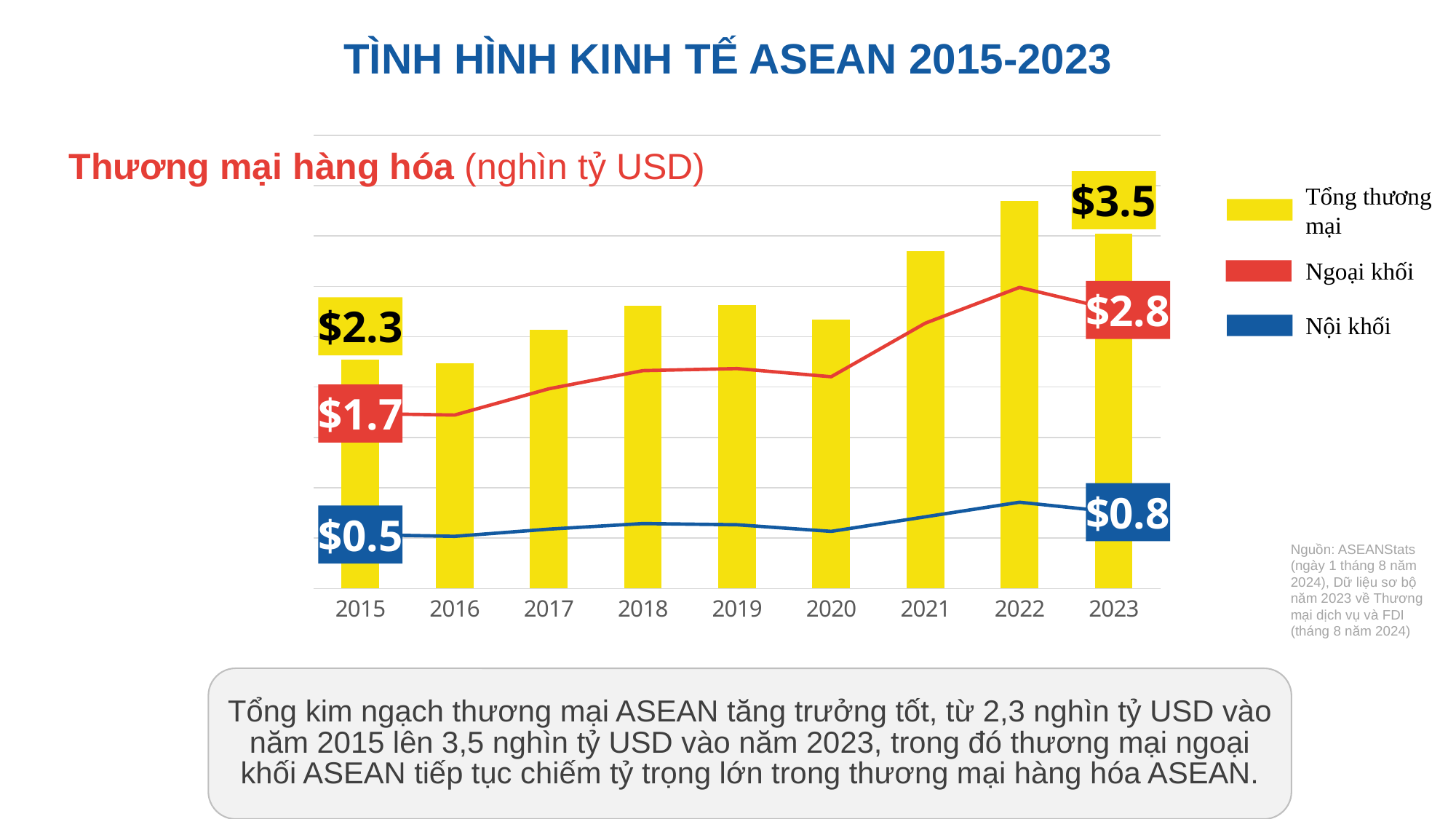
By how much did Tổng thương mại increase from 2015 to 2023? $1.2 What kind of chart is this? Combined bar and line chart What is the difference between Ngoại khối and Nội khối in 2023? $2.0 How many series does the legend list? 3 Which is larger in 2015, Ngoại khối or Nội khối? Ngoại khối What is the value of Tổng thương mại in 2015? $2.3 What is the value of Ngoại khối in 2015? $1.7 Does Tổng thương mại generally rise or fall from 2015 to 2023? Rise What is the value of Tổng thương mại in 2023? $3.5 What is the value of Nội khối in 2023? $0.8 What is the value of Ngoại khối in 2023? $2.8 How many years are shown on the x axis? 9